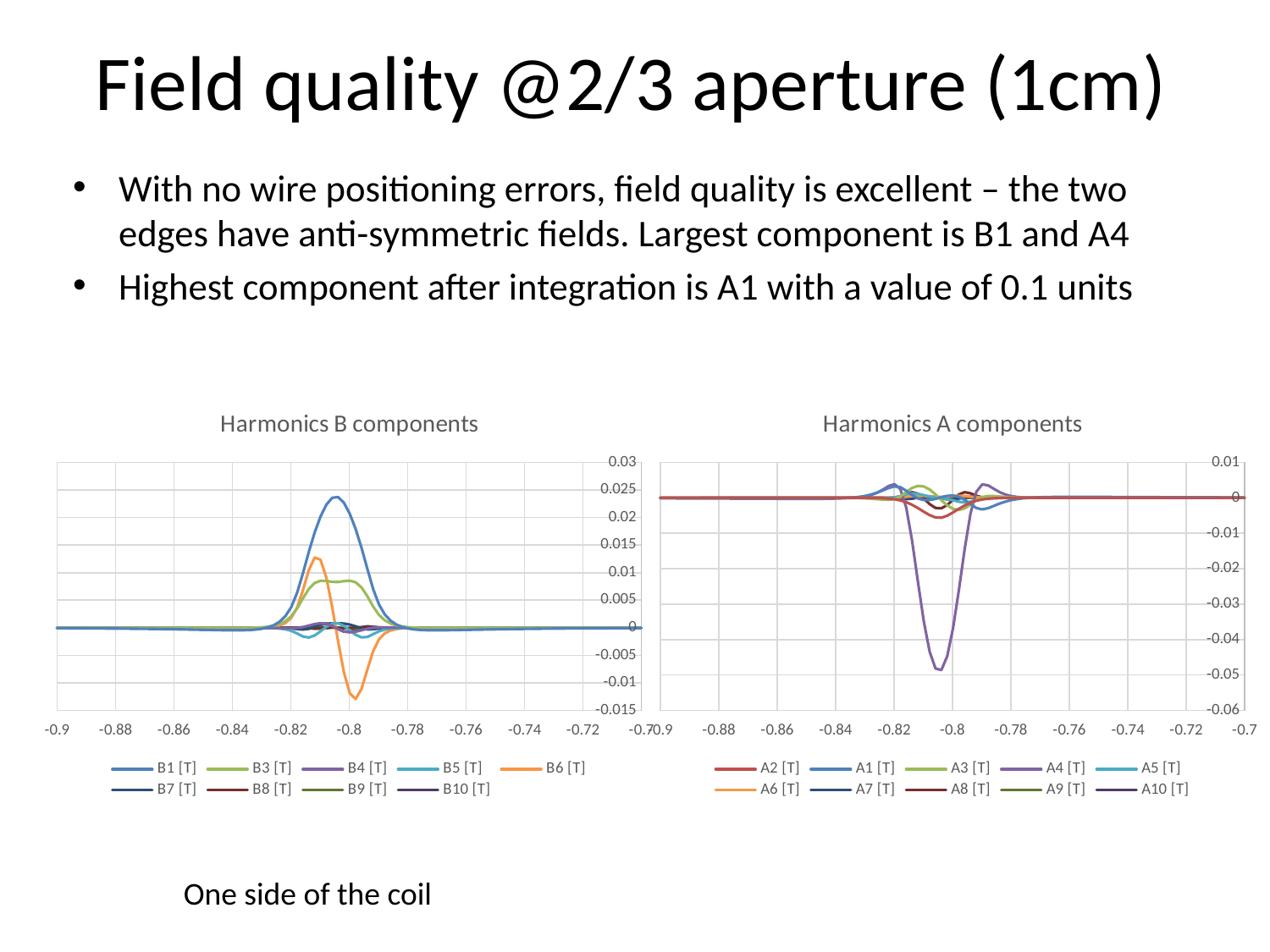
What kind of chart is the 'Harmonics B components' chart? line chart In the 'Harmonics B components' chart, which series has the larger peak, B1 [T] or B3 [T]? B1 [T] In the 'Harmonics A components' chart, which series reaches the lowest (most negative) value? A4 [T] In the 'Harmonics B components' chart, which series reaches the highest peak value? B1 [T] How many series does the legend of the 'Harmonics B components' chart list? 9 In the 'Harmonics B components' chart, is the minimum value of B6 [T] greater or less than -0.01? less In the 'Harmonics B components' chart, which series reaches the lowest (most negative) value? B6 [T] What is the maximum value shown on the vertical axis of the 'Harmonics A components' chart? 0.01 In the 'Harmonics A components' chart, is the minimum value of A4 [T] greater or less than -0.04? less In the 'Harmonics B components' chart, is the peak value of B1 [T] greater or less than 0.02? greater How many series does the legend of the 'Harmonics A components' chart list? 10 What is the title of the chart on the left side of the slide? Harmonics B components